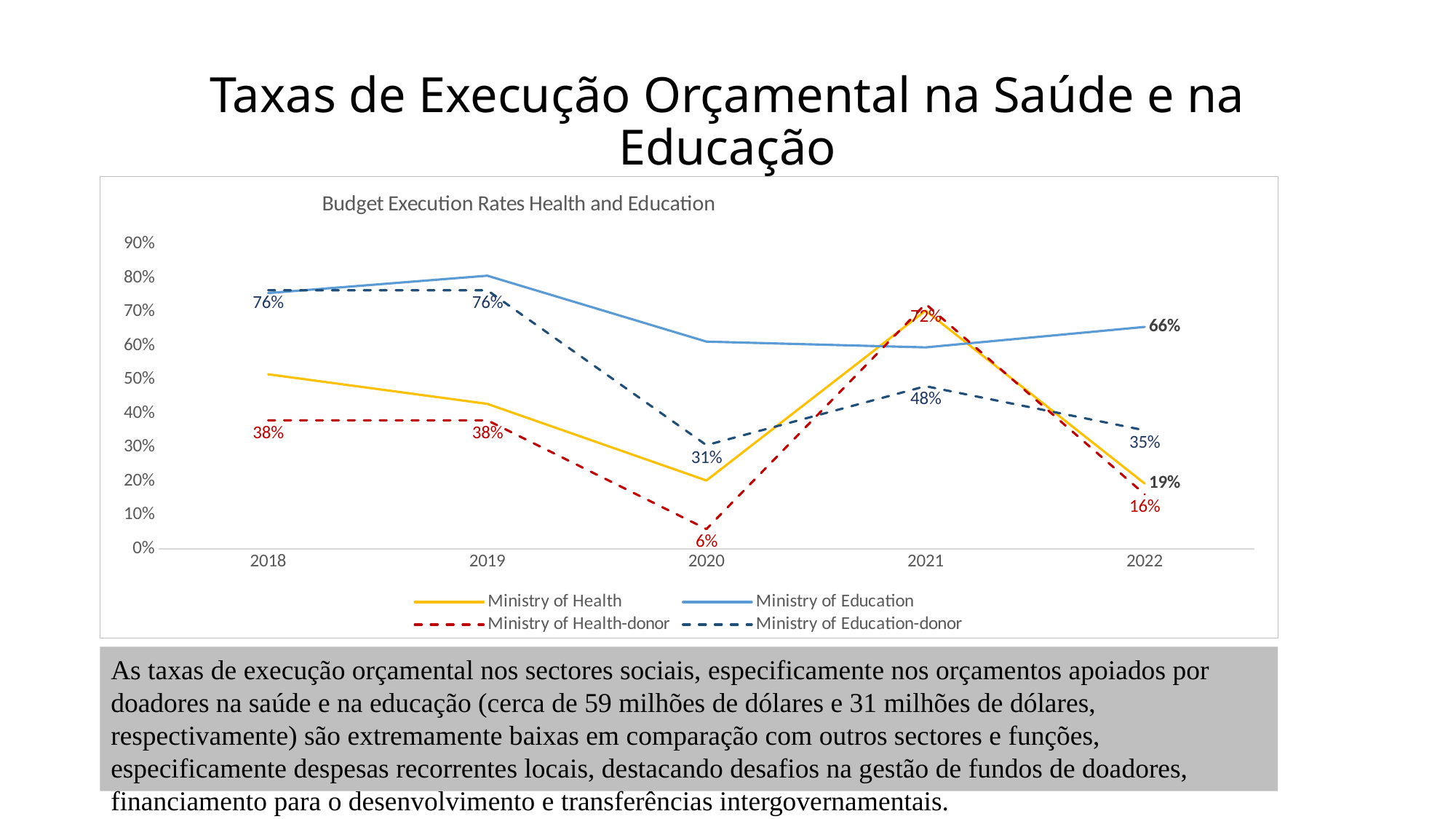
What is the value for Ministry of Health-donor in 2020? 6% In 2022, which is larger: Ministry of Health-donor or Ministry of Education-donor? Ministry of Education-donor What kind of chart is shown on the slide? Line chart How many years are shown on the x axis? 5 What is the value for Ministry of Health-donor in 2021? 72% Is the value for Ministry of Education in 2019 greater or less than 70%? greater What is the difference between the Ministry of Education-donor values for 2019 and 2020? 45 percentage points What is the value for Ministry of Education-donor in 2018? 76% Is the value for Ministry of Health in 2018 greater or less than 40%? greater What is the value for Ministry of Education in 2022? 66% How many series does the legend list? 4 In which year is the Ministry of Health-donor value lowest? 2020